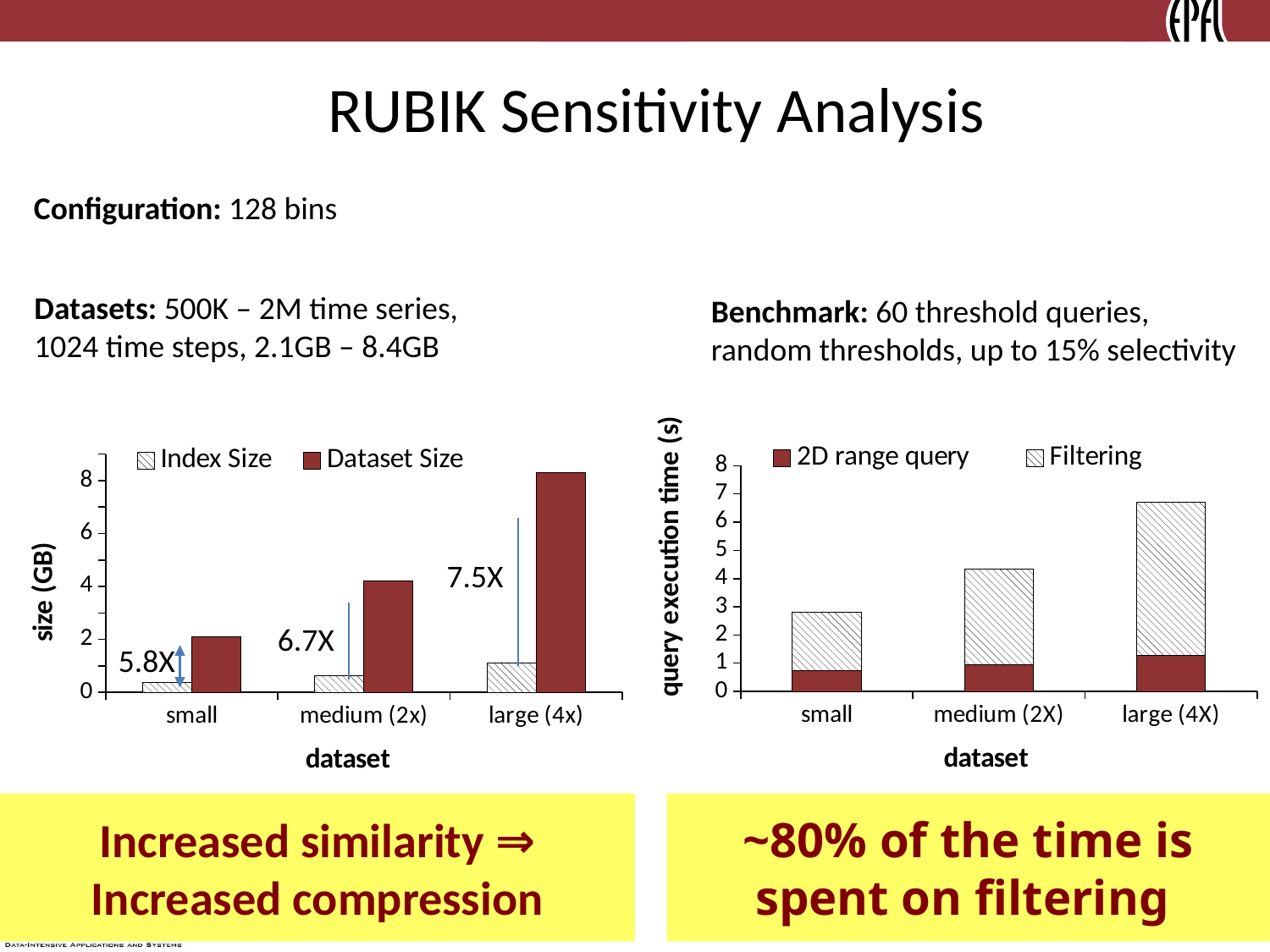
What kind of chart is the right chart (query execution time vs dataset)? stacked bar chart In the right chart, how many datasets are shown on the x axis? 3 In the left chart, what compression ratio is annotated for the medium (2x) dataset? 6.7X What kind of chart is the left chart (size (GB) vs dataset)? bar chart In the left chart, how many series does the legend list? 2 In the right chart, is the total query execution time for large (4X) greater or less than 6? greater In the left chart, which dataset has the highest Dataset Size? large (4x) In the left chart, is the Dataset Size for large (4x) greater or less than 6? greater In the right chart, which dataset has the lowest total query execution time? small In the right chart, what are the two series listed in the legend? 2D range query and Filtering In the left chart, is the Index Size for small greater or less than 2? less In the left chart, what compression ratio is annotated for the large (4x) dataset? 7.5X